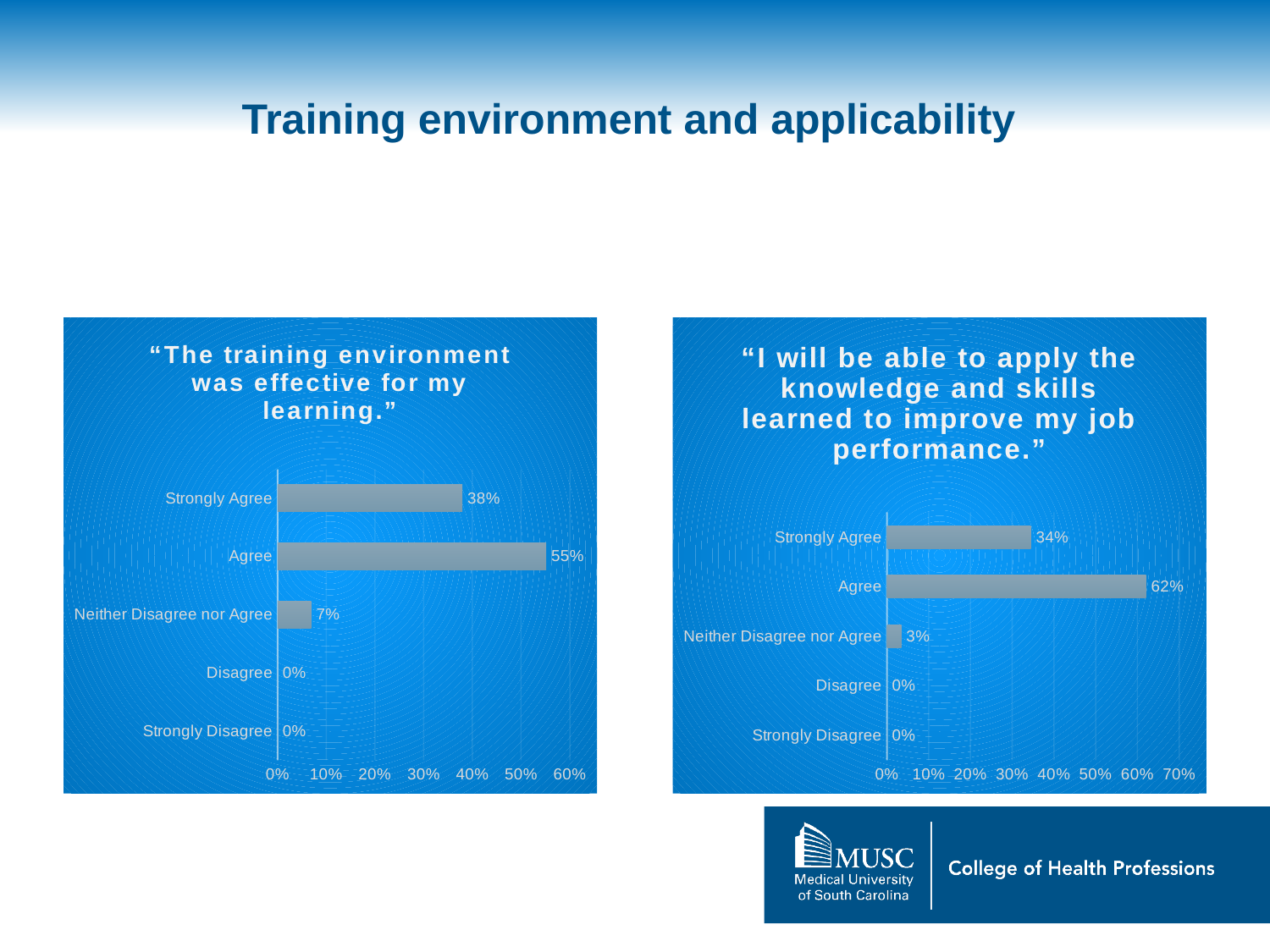
What kind of chart is the left chart ("The training environment was effective for my learning.")? Bar chart Which is larger: the value for Strongly Agree in the left chart or the value for Strongly Agree in the right chart? Left chart (38%) In the left chart ("The training environment was effective for my learning."), what is the difference between the values for Agree and Strongly Agree? 17% In the left chart ("The training environment was effective for my learning."), what is the value for Agree? 55% What is the title of the slide? Training environment and applicability How many categories are shown in the right chart ("I will be able to apply the knowledge and skills learned to improve my job performance.")? 5 In the right chart ("I will be able to apply the knowledge and skills learned to improve my job performance."), what is the difference between the values for Agree and Strongly Agree? 28% In the left chart ("The training environment was effective for my learning."), is the value for Agree greater or less than 50%? greater In the left chart ("The training environment was effective for my learning."), what is the value for Strongly Agree? 38% In the left chart ("The training environment was effective for my learning."), what is the value for Disagree? 0% In the right chart ("I will be able to apply the knowledge and skills learned to improve my job performance."), which category has the highest value? Agree In the right chart ("I will be able to apply the knowledge and skills learned to improve my job performance."), what is the value for Neither Disagree nor Agree? 3%